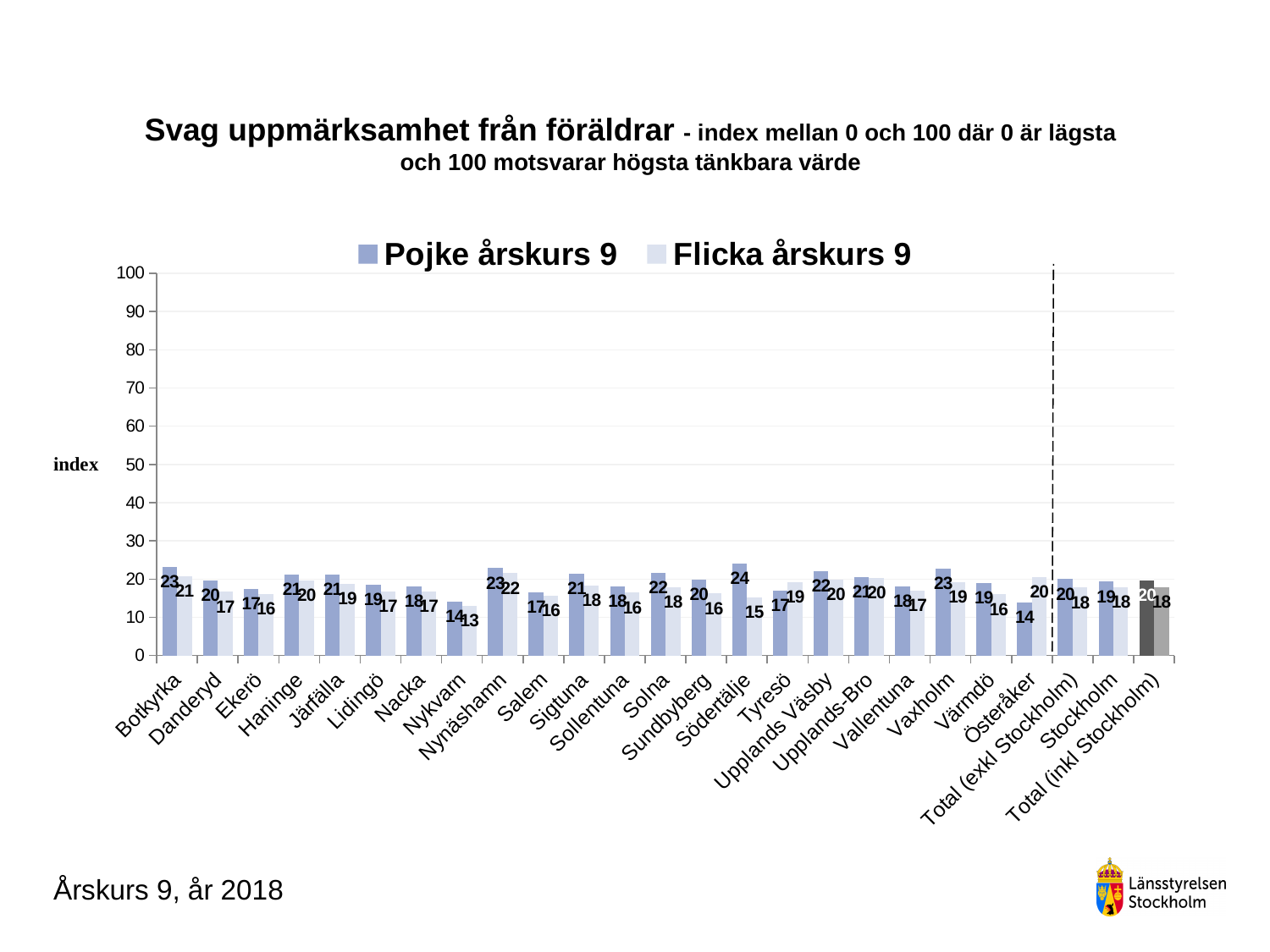
What is the value for Pojke årskurs 9 in Södertälje? 24 How many series does the legend list? 2 Which category has the highest value for Pojke årskurs 9? Södertälje In Tyresö, which is larger: the Pojke årskurs 9 value or the Flicka årskurs 9 value? Flicka årskurs 9 How many categories are shown on the x axis? 25 Which category has the lowest value for Flicka årskurs 9? Nykvarn What is the value for Flicka årskurs 9 in Nykvarn? 13 What is the difference between the Pojke årskurs 9 and Flicka årskurs 9 values in Södertälje? 9 What is the value for Flicka årskurs 9 in Österåker? 20 What is the value for Pojke årskurs 9 for Total (inkl Stockholm)? 20 What kind of chart is shown on the slide? Bar chart Which category has the highest value for Flicka årskurs 9? Nynäshamn